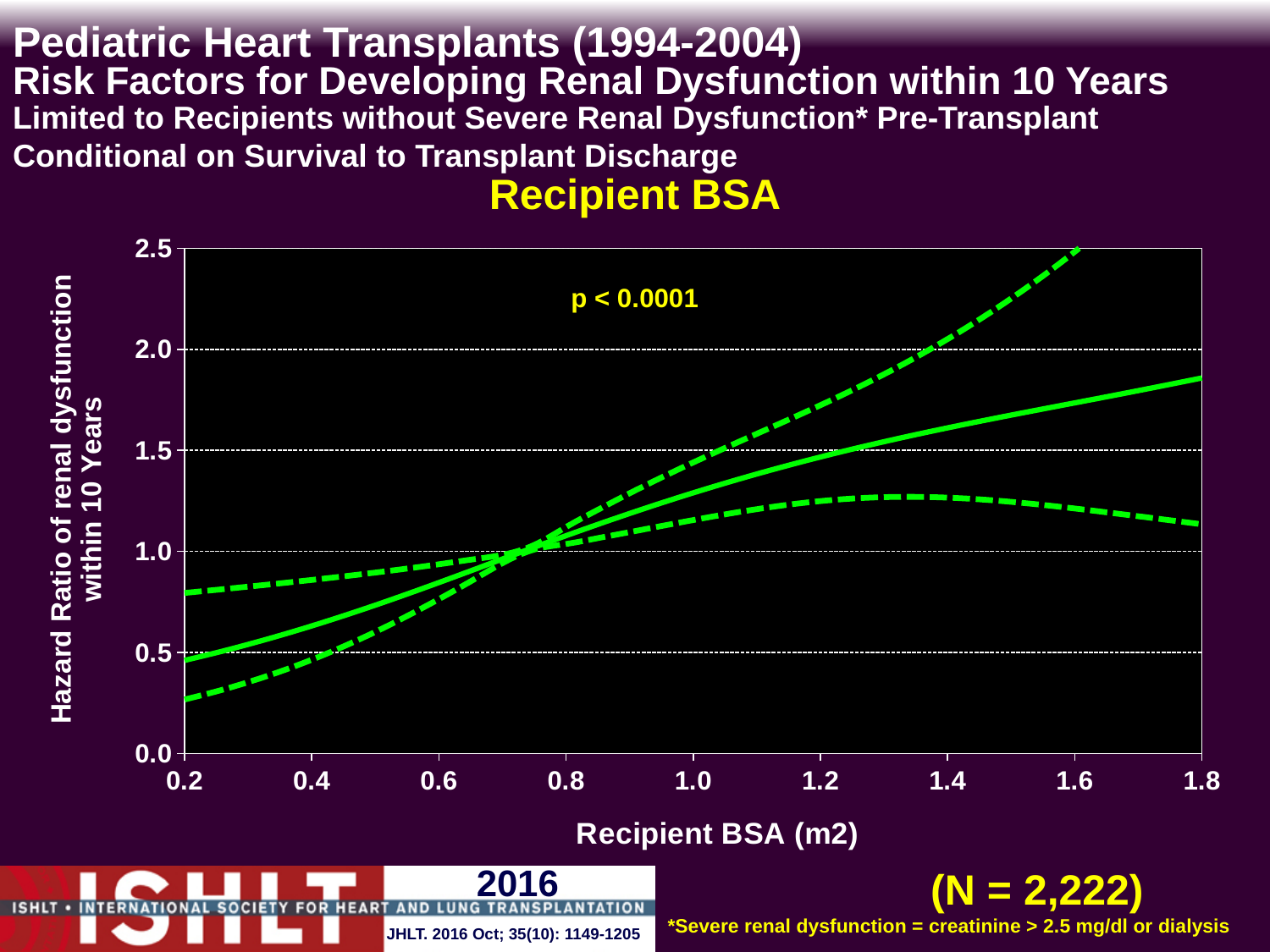
Is the value of the lower dashed line at a Recipient BSA of 0.2 greater or less than 0.5? less What is the label of the x axis of the chart? Recipient BSA (m2) Does the solid line for hazard ratio rise or fall as Recipient BSA increases from 0.2 to 1.8? rise How many lines are plotted on the chart? 3 Is the hazard ratio on the solid line at a Recipient BSA of 1.8 greater or less than 1.5? greater Is the hazard ratio on the solid line at a Recipient BSA of 0.4 greater or less than 1.0? less What is the highest value shown on the y axis of the chart? 2.5 What kind of chart is shown on the slide? line chart